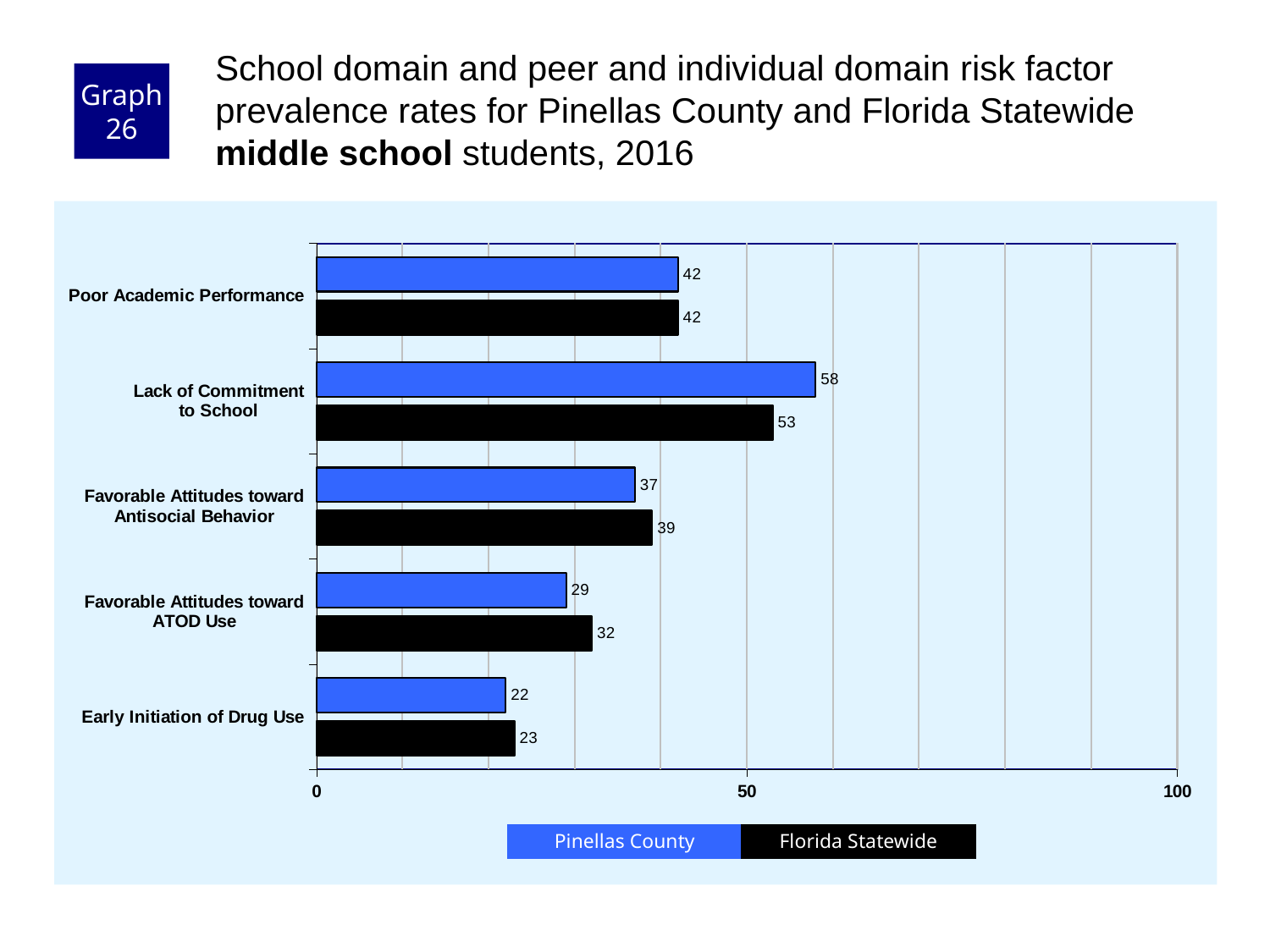
Is the Pinellas County value for Lack of Commitment to School greater or less than 50? greater Which colour represents Florida Statewide in the chart? Black Which risk factor has the lowest Florida Statewide value? Early Initiation of Drug Use How many risk factor categories are shown on the chart? 5 What type of chart is shown? Bar chart Which risk factor has the highest Pinellas County value? Lack of Commitment to School What is the Florida Statewide value for Favorable Attitudes toward ATOD Use? 32 What is the difference between the Pinellas County and Florida Statewide values for Lack of Commitment to School? 5 What is the Pinellas County value for Early Initiation of Drug Use? 22 What is the Pinellas County value for Lack of Commitment to School? 58 Which is larger for Favorable Attitudes toward Antisocial Behavior: Pinellas County or Florida Statewide? Florida Statewide How many series does the legend list? 2